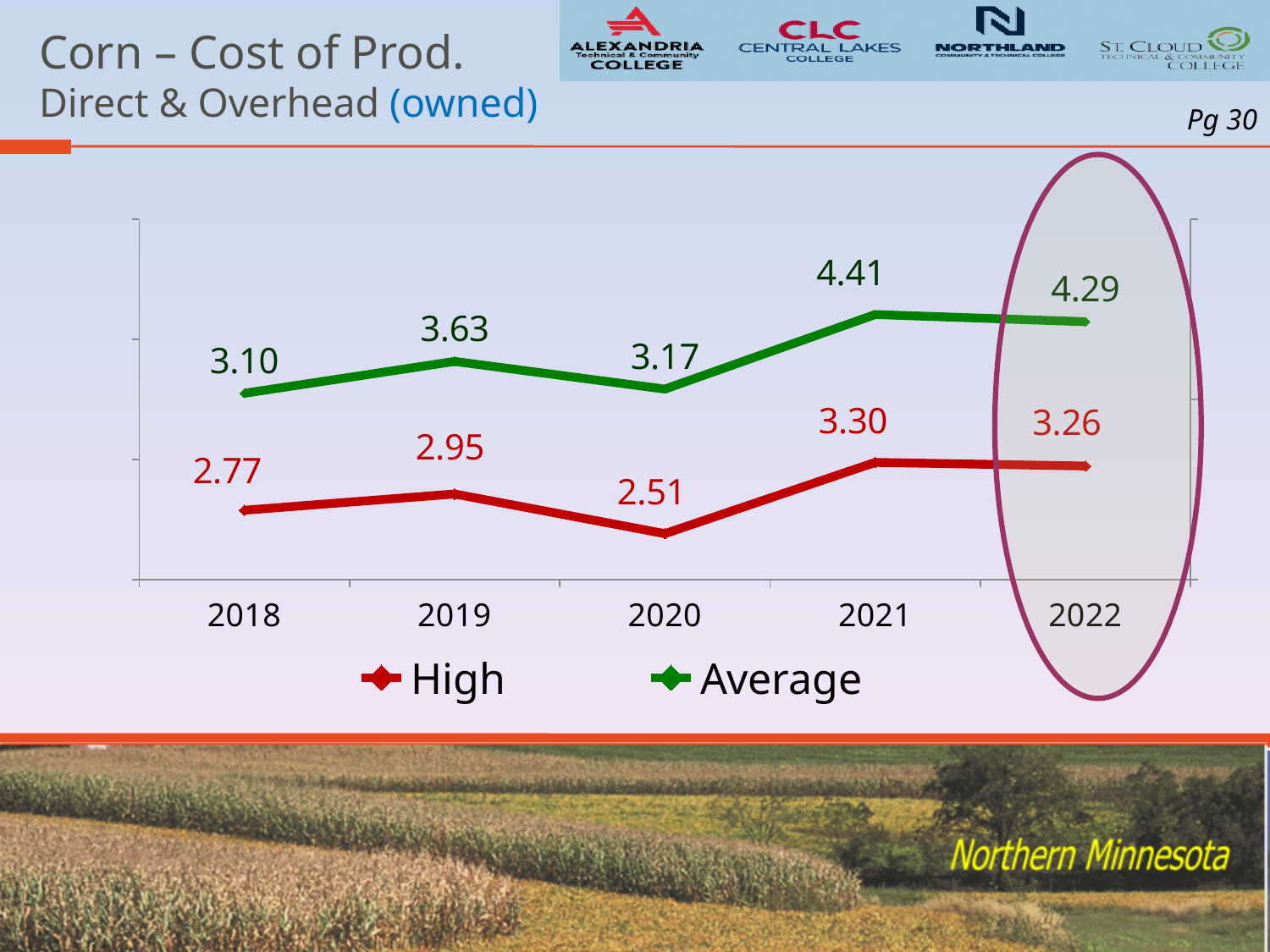
What is the Average value for 2021? 4.41 Which is larger, the High value for 2021 or the High value for 2018? 2021 What is the High value for 2020? 2.51 Does the Average series rise or fall from 2020 to 2021? rise What is the difference between the Average and High values in 2019? 0.68 How many series does the legend list? 2 How many years are shown on the x axis? 5 In which year is the High series lowest? 2020 In which year is the Average series highest? 2021 What kind of chart is shown on the slide? line chart What is the High value for 2022? 3.26 What is the Average value for 2018? 3.10